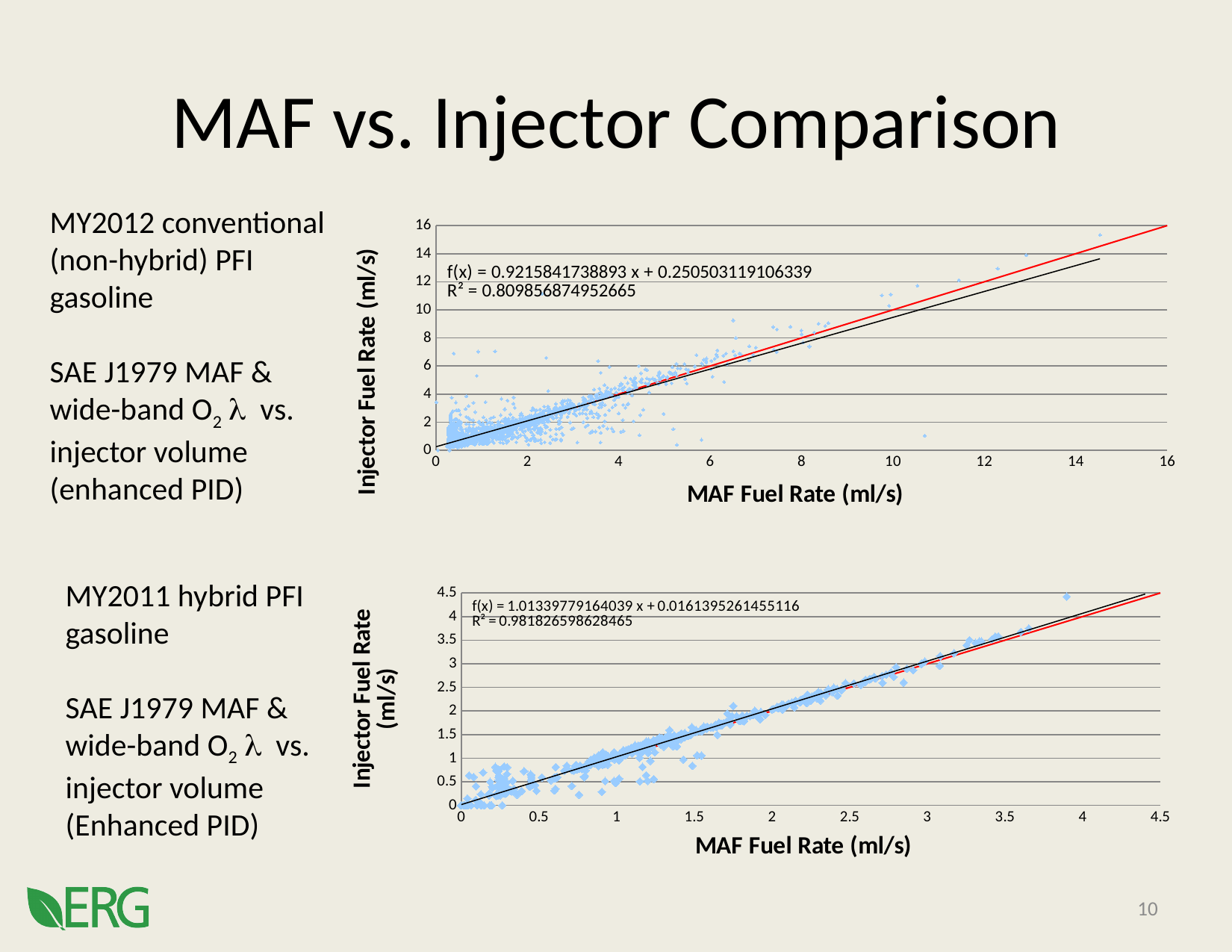
In the bottom chart, what is the R² value printed for the fitted line? 0.981826598628465 What kind of chart is the top chart on the slide? Scatter chart In the top chart, do the Injector Fuel Rate values generally rise or fall as MAF Fuel Rate increases? Rise What is the maximum value shown on the x axis of the top chart? 16 Which chart has the higher R² value, the top chart or the bottom chart? The bottom chart In the top chart, what is the R² value printed for the fitted line? 0.809856874952665 In the bottom chart, what is the fitted equation f(x) printed on the chart? f(x) = 1.01339779164039 x + 0.0161395261455116 In the top chart, is the R² value greater or less than 0.9? less In the top chart, what is the fitted equation f(x) printed on the chart? f(x) = 0.9215841738893 x + 0.250503119106339 What kind of chart is the bottom chart on the slide? Scatter chart What is the x-axis title of the bottom chart? MAF Fuel Rate (ml/s) In the bottom chart, is the slope of the fitted line greater or less than 1? greater